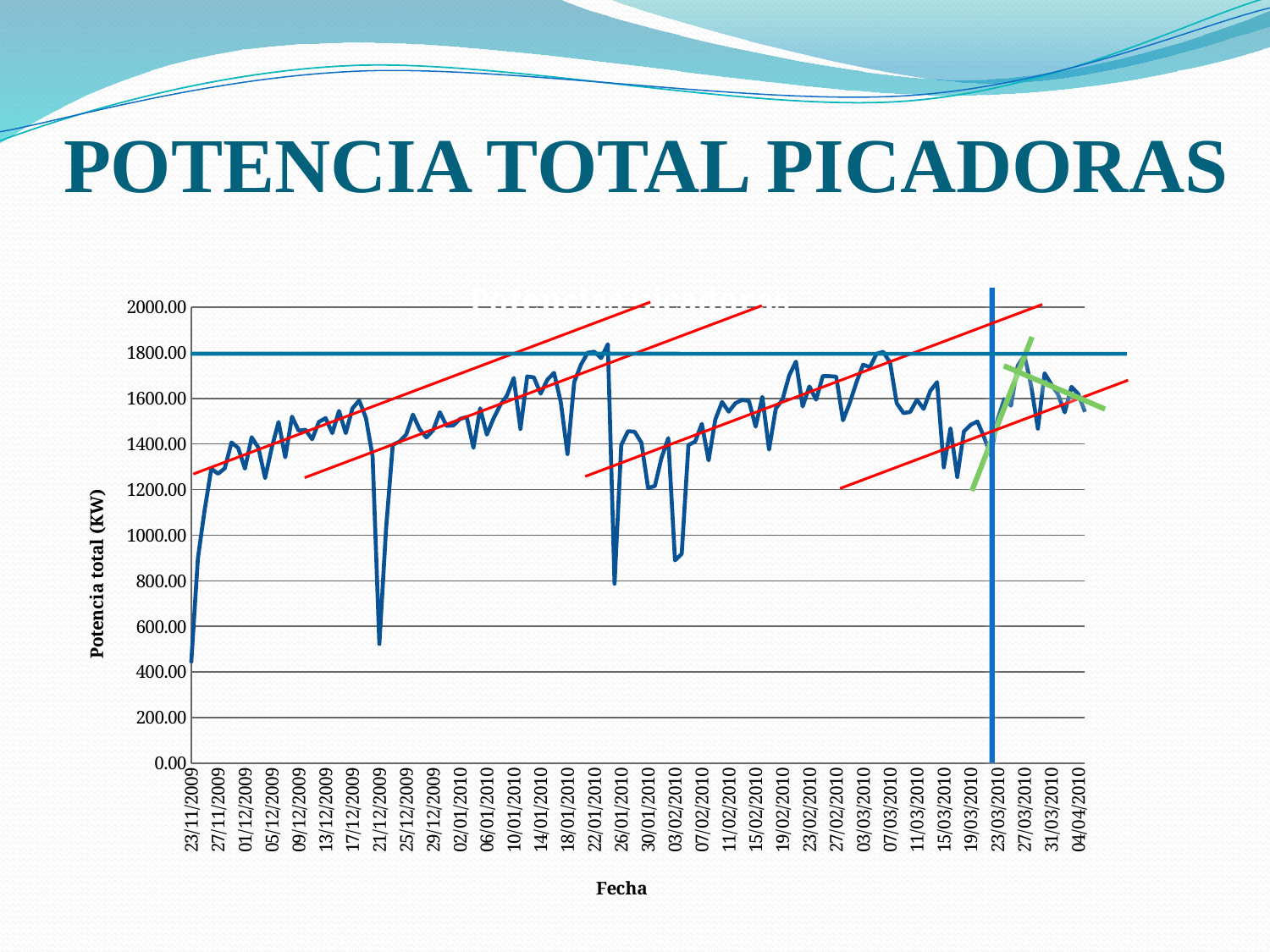
Is the value for 23/11/2009 greater or less than 600? less What is the last date shown on the horizontal axis? 04/04/2010 Does the value rise or fall between 23/11/2009 and 27/11/2009? rise What is the label of the vertical axis? Potencia total (KW) Is the value at the dip around 21/12/2009 greater or less than 800? less What kind of chart is shown on the slide? line chart What is the highest value shown on the vertical axis? 2000.00 What is the label of the horizontal axis? Fecha What is the first date shown on the horizontal axis? 23/11/2009 Is the value for 04/04/2010 greater or less than 1400? greater Which is larger, the value for 23/11/2009 or the value for 04/04/2010? 04/04/2010